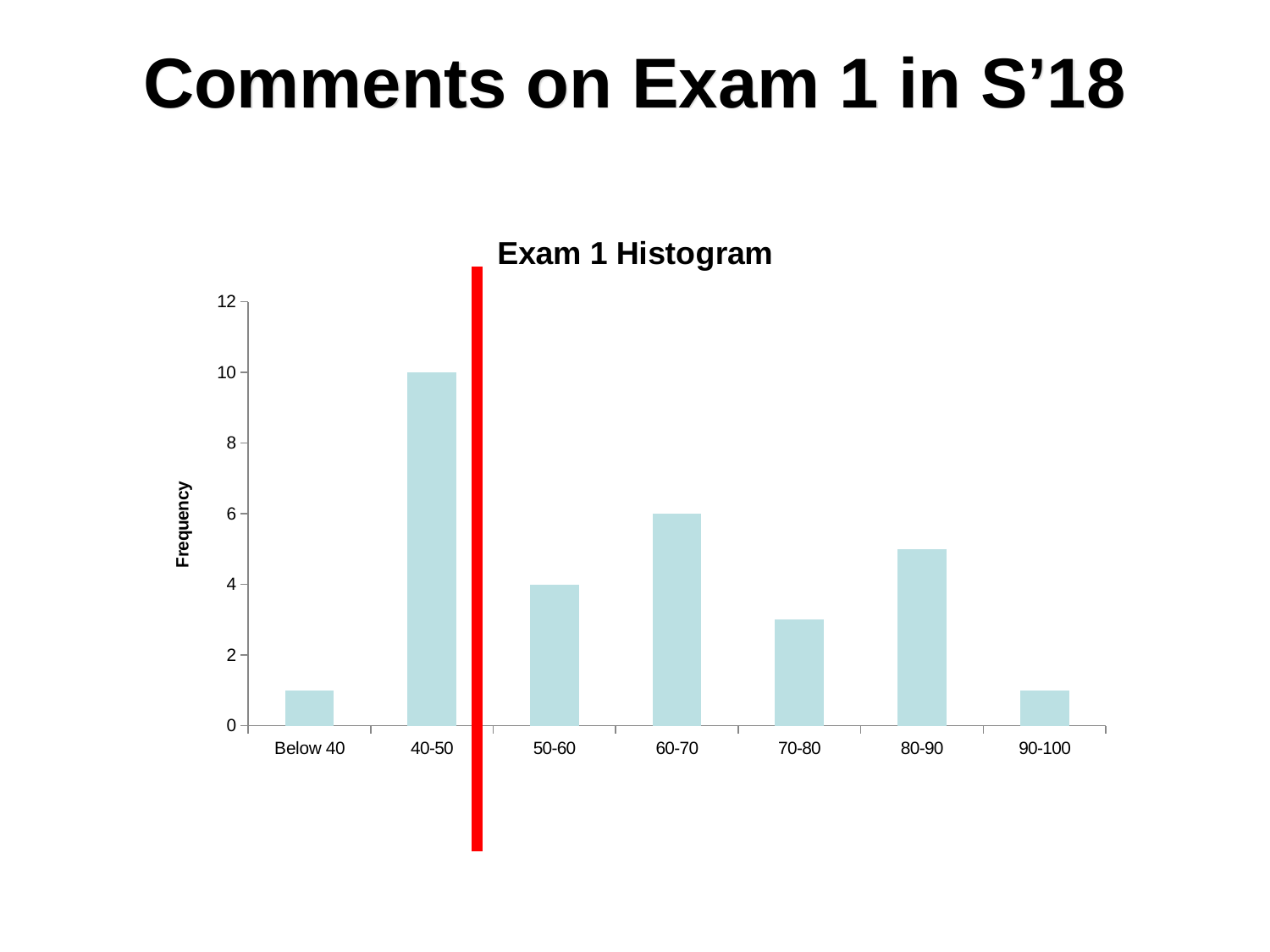
What is the label on the vertical axis of the chart? Frequency Which has a higher frequency, 60-70 or 80-90? 60-70 Which category has the highest frequency? 40-50 What kind of chart is shown on the slide? bar chart Is the frequency for the 80-90 category greater or less than 4? greater What is the frequency for the 40-50 category in the Exam 1 Histogram? 10 How many score categories are shown on the x axis? 7 What is the frequency for the 60-70 category? 6 What is the frequency for the 50-60 category? 4 Which has a higher frequency, 50-60 or 70-80? 50-60 What is the difference in frequency between the 40-50 and 60-70 categories? 4 Is the frequency for the Below 40 category greater or less than 2? less